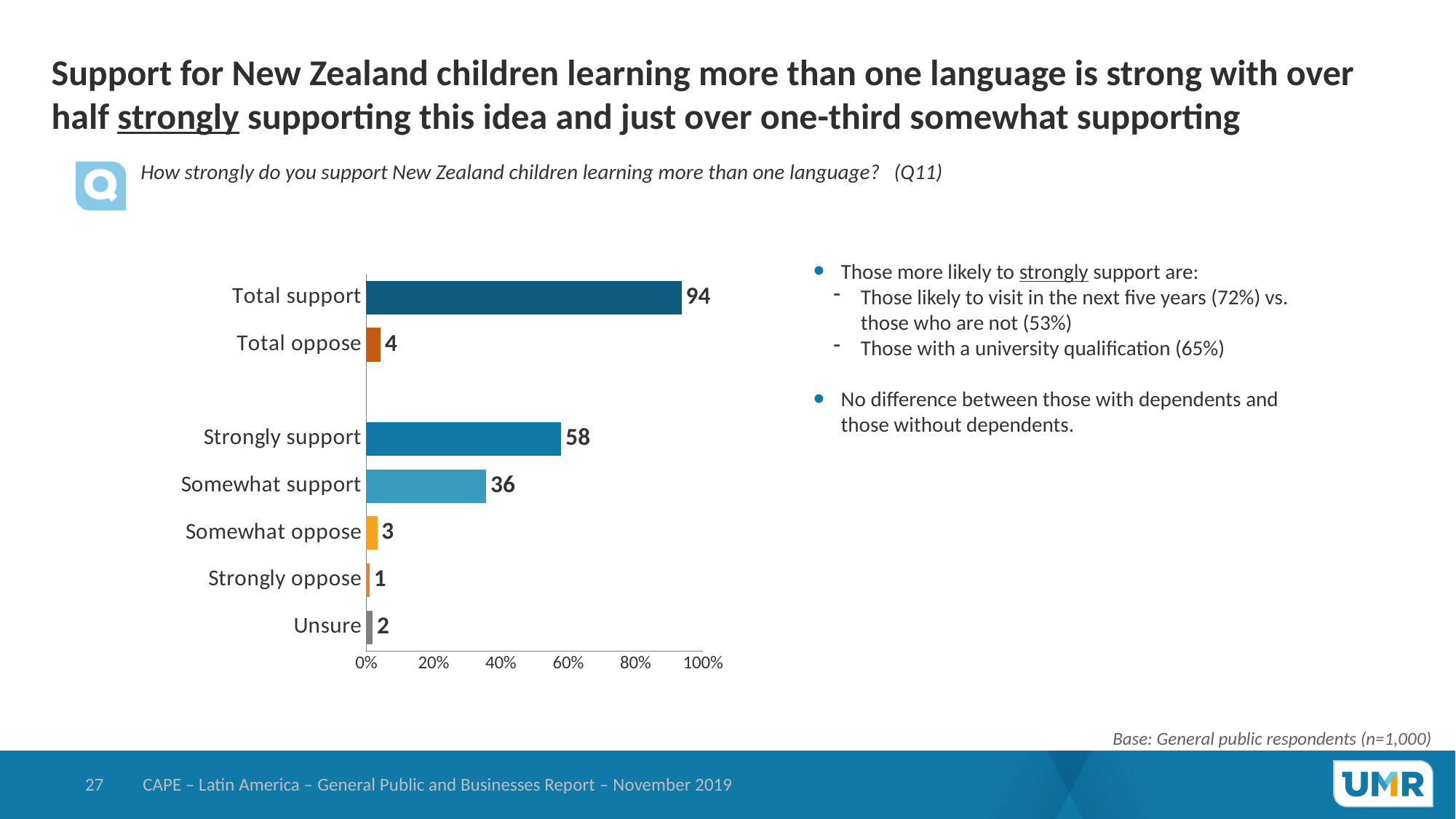
How many categories are shown on the chart? 7 What is the value for Strongly support? 58 What is the difference between Strongly support and Somewhat support? 22 Which category has the lowest value? Strongly oppose Which is larger, Somewhat oppose or Unsure? Somewhat oppose What is the value for Total support? 94 What is the value for Somewhat support? 36 Is the value for Strongly support greater or less than 40%? greater What is the highest value shown on the x axis? 100% Which category has the highest value? Total support What is the value for Unsure? 2 What kind of chart is shown on the slide? Bar chart